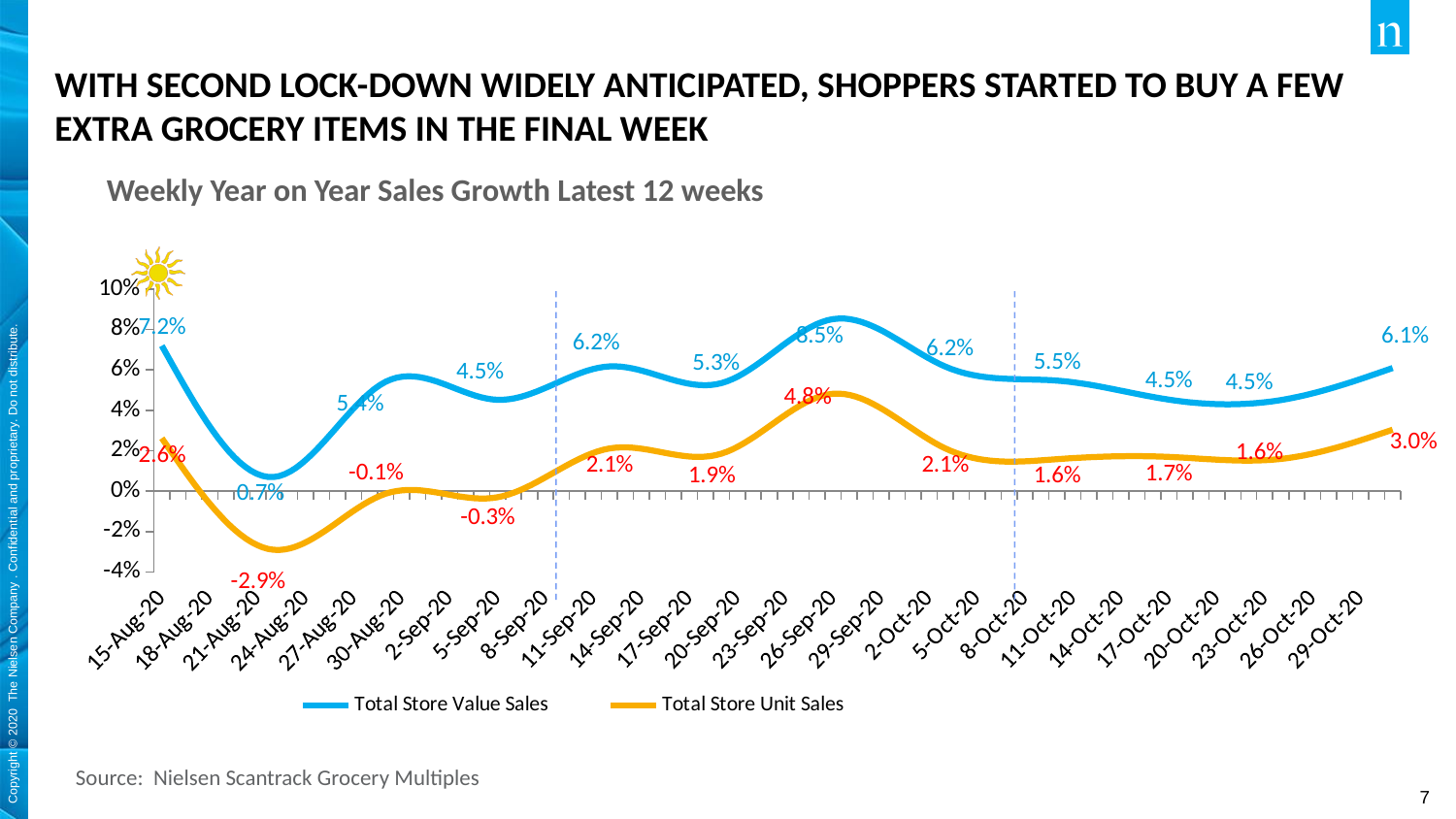
What is the title of the chart? Weekly Year on Year Sales Growth Latest 12 weeks What is the highest value shown for Total Store Value Sales? 8.5% What is the Total Store Value Sales growth for the final week (29-Oct-20)? 6.1% What is the lowest value shown for Total Store Unit Sales? -2.9% What is the highest value shown for Total Store Unit Sales? 4.8% What kind of chart is shown on the slide? Line chart In the final week, how much higher is Total Store Value Sales growth than Total Store Unit Sales growth? 3.1% What is the lowest value shown for Total Store Value Sales? 0.7% What is the Total Store Unit Sales growth for the final week (29-Oct-20)? 3.0% How many series does the legend list? 2 How many weekly data points are plotted for the Total Store Value Sales series? 12 What is the Total Store Value Sales growth for the first week (15-Aug-20)? 7.2%